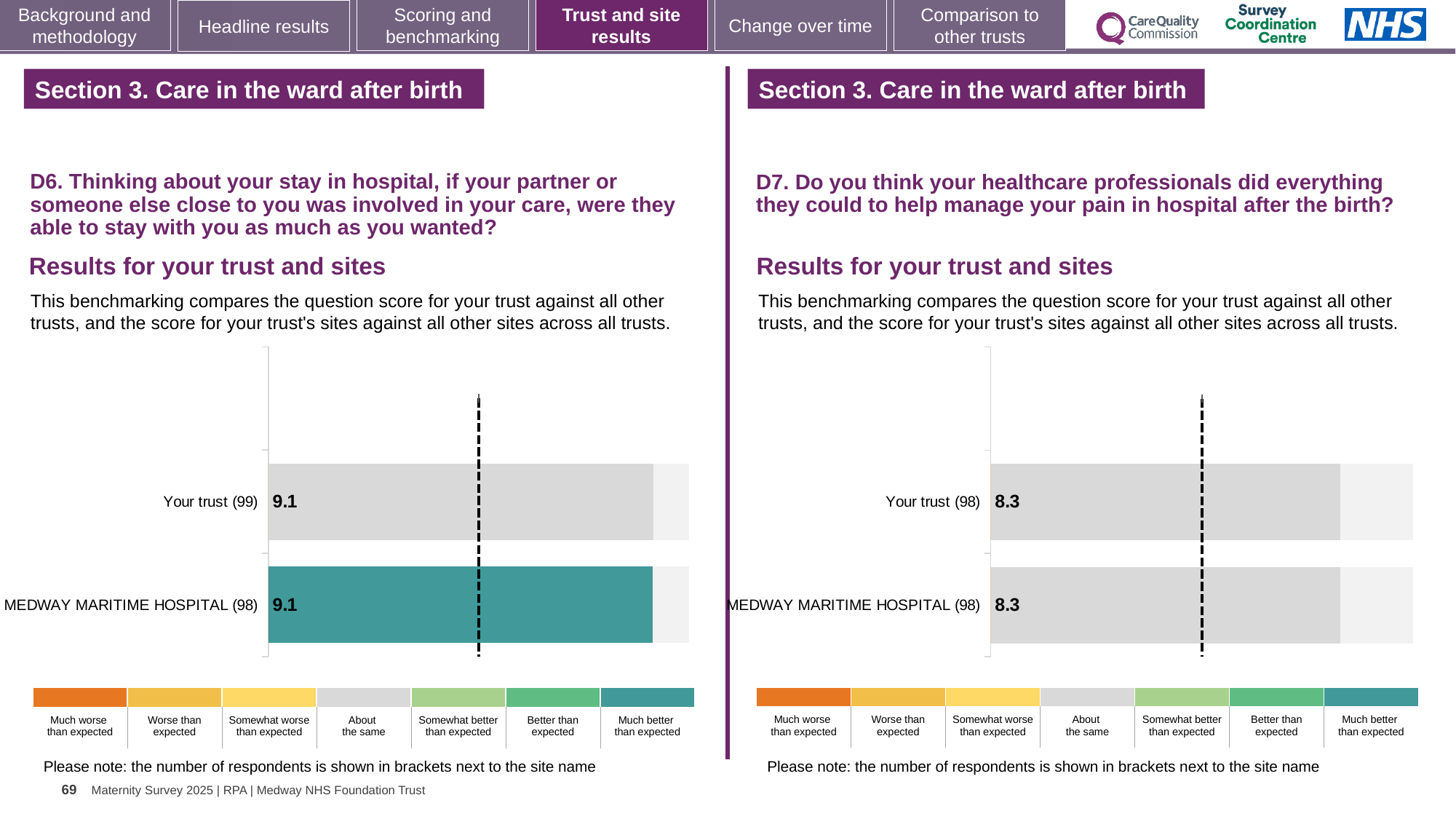
In the D6 chart on the left, what is the score for MEDWAY MARITIME HOSPITAL? 9.1 In the D7 chart on the right, what is the difference between the score for Your trust and the score for MEDWAY MARITIME HOSPITAL? 0.0 In the D6 chart on the left, which benchmark category does the colour of the MEDWAY MARITIME HOSPITAL bar correspond to in the legend? Much better than expected In the D7 chart on the right, what is the score for Your trust? 8.3 In the D6 chart on the left, what is the score for Your trust? 9.1 How many bars are plotted in the D7 chart on the right? 2 In the D7 chart on the right, how many respondents are shown in brackets for Your trust? 98 In the D6 chart on the left, how many respondents are shown in brackets for MEDWAY MARITIME HOSPITAL? 98 How many bars are plotted in the D6 chart on the left? 2 In the D6 chart on the left, what is the difference between the score for Your trust and the score for MEDWAY MARITIME HOSPITAL? 0.0 In the D7 chart on the right, what is the score for MEDWAY MARITIME HOSPITAL? 8.3 What kind of chart is the D7 chart on the right? Bar chart